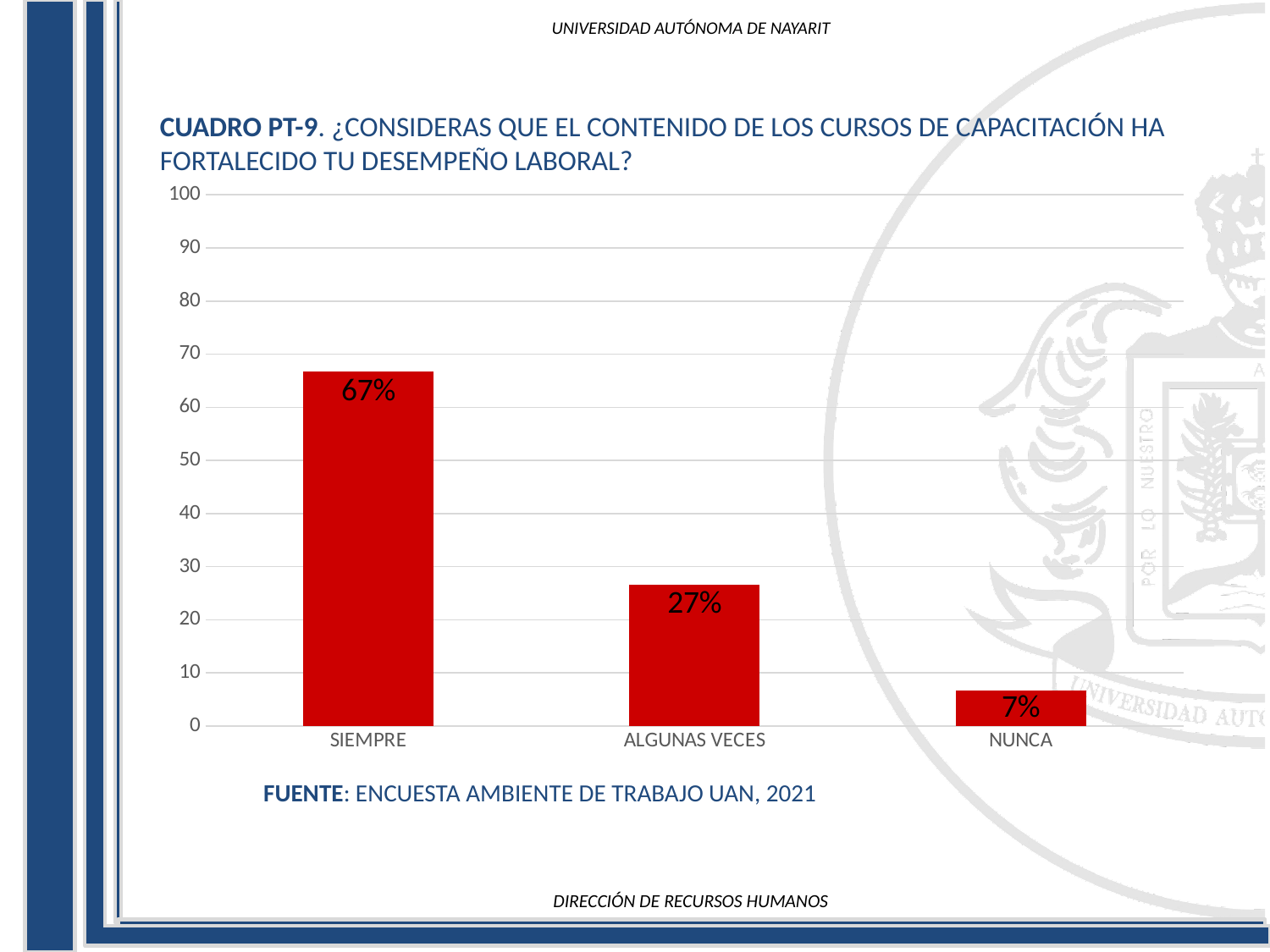
Which category has the highest value? SIEMPRE What is the difference between the values for ALGUNAS VECES and NUNCA? 20% Which category has the lowest value? NUNCA What is the value for NUNCA? 7% What is the value for SIEMPRE? 67% How many categories are shown on the x axis? 3 What is the value for ALGUNAS VECES? 27% What is the difference between the values for SIEMPRE and ALGUNAS VECES? 40% What kind of chart is shown on the slide? bar chart Which is larger, the value for ALGUNAS VECES or the value for NUNCA? ALGUNAS VECES Is the value for SIEMPRE greater or less than 60? greater What source is cited below the chart? ENCUESTA AMBIENTE DE TRABAJO UAN, 2021